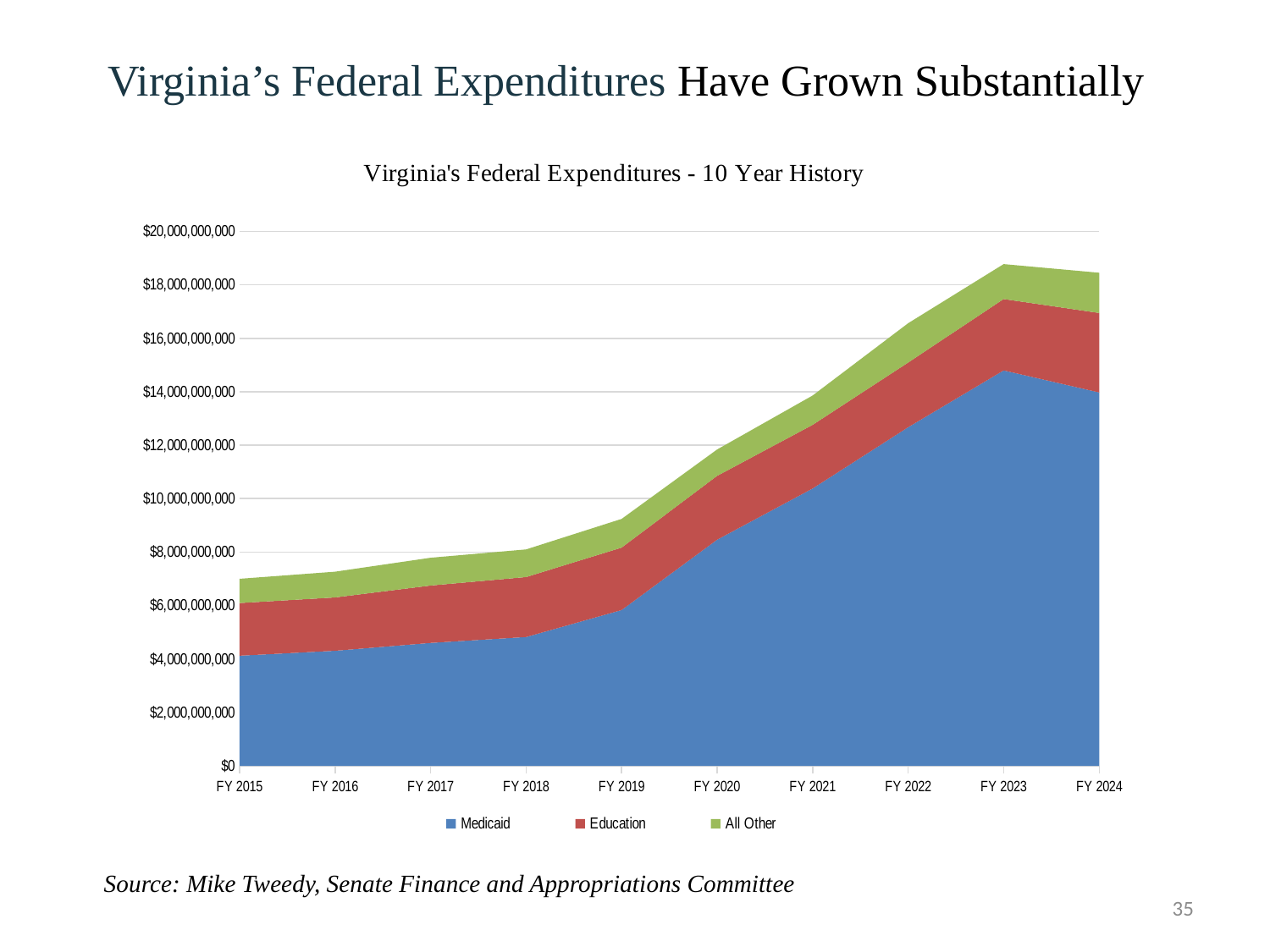
Is the Medicaid value for FY 2015 greater or less than $6,000,000,000? less In which fiscal year is the total federal expenditure lowest? FY 2015 In which fiscal year is the total federal expenditure highest? FY 2023 How many series does the legend list? 3 Is the total federal expenditure for FY 2019 greater or less than $8,000,000,000? greater Does the total federal expenditure rise or fall from FY 2015 to FY 2023? rise What kind of chart is shown on the slide? Area chart Which series accounts for the largest share of expenditures in FY 2024? Medicaid Which series is shown in blue? Medicaid Is the total federal expenditure for FY 2023 greater or less than $18,000,000,000? greater How many fiscal years are shown on the x axis? 10 What is the title of the chart? Virginia's Federal Expenditures - 10 Year History